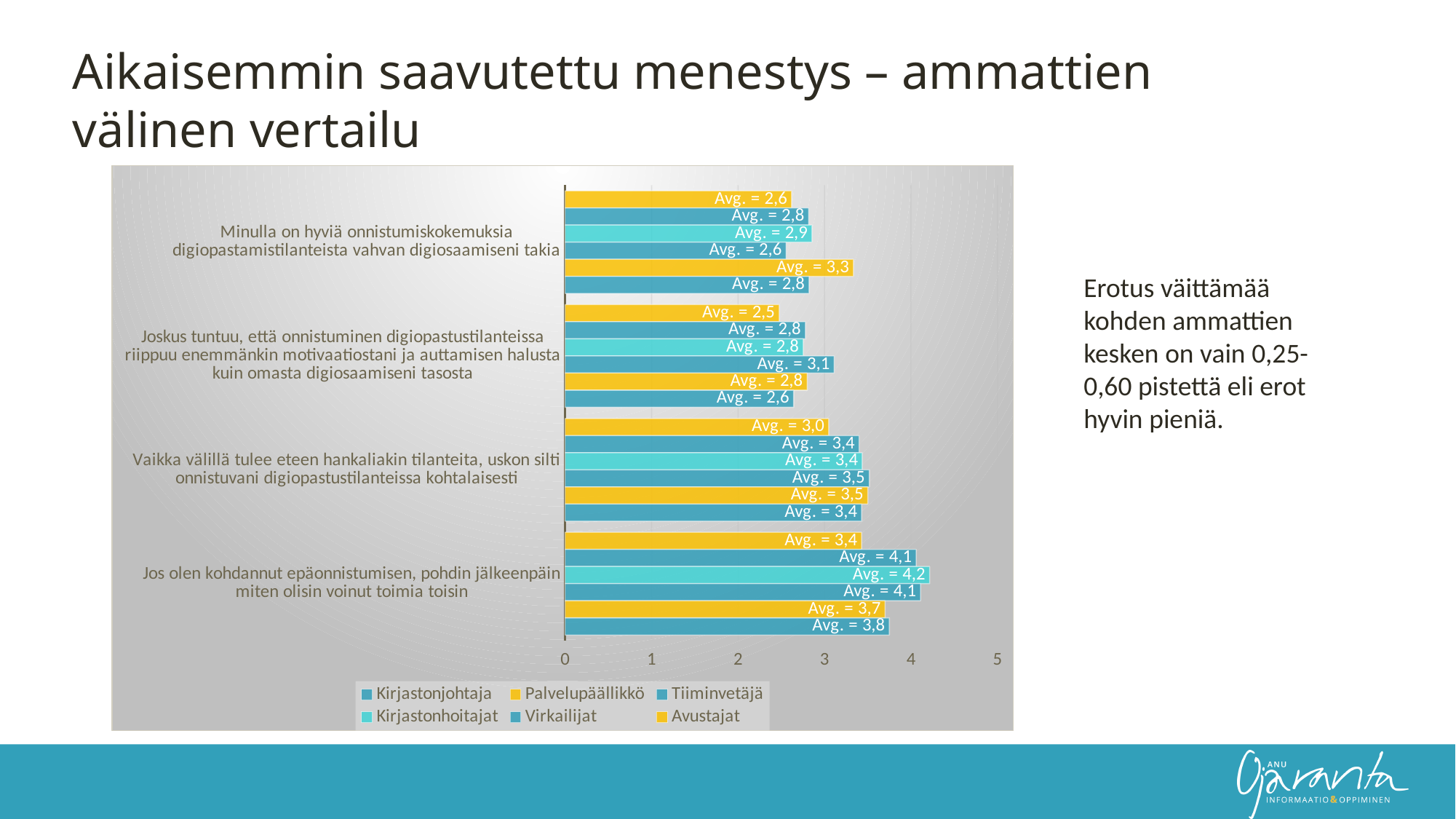
What is the value for Kirjastonhoitajat for the statement "Minulla on hyviä onnistumiskokemuksia digiopastamistilanteista vahvan digiosaamiseni takia"? Avg. = 2,9 Is the Kirjastonhoitajat value for "Jos olen kohdannut epäonnistumisen..." greater or less than 4? greater For Kirjastonhoitajat, which statement has the larger value: "Vaikka välillä tulee eteen hankaliakin tilanteita..." or "Joskus tuntuu, että onnistuminen digiopastustilanteissa..."? Vaikka välillä tulee eteen hankaliakin tilanteita... How many series does the legend list? 6 What is the lowest value shown anywhere in the chart? Avg. = 2,5 How many statements (categories) are plotted on the vertical axis? 4 What is the highest value shown anywhere in the chart? Avg. = 4,2 What is the maximum value shown on the horizontal axis? 5 What is the value for Kirjastonhoitajat for the statement "Jos olen kohdannut epäonnistumisen, pohdin jälkeenpäin miten olisin voinut toimia toisin"? Avg. = 4,2 What is the difference between the Kirjastonhoitajat values for "Jos olen kohdannut epäonnistumisen..." (4,2) and "Minulla on hyviä onnistumiskokemuksia..." (2,9)? 1,3 What type of chart is shown on the slide? bar chart For the statement "Jos olen kohdannut epäonnistumisen...", which series has the highest value? Kirjastonhoitajat